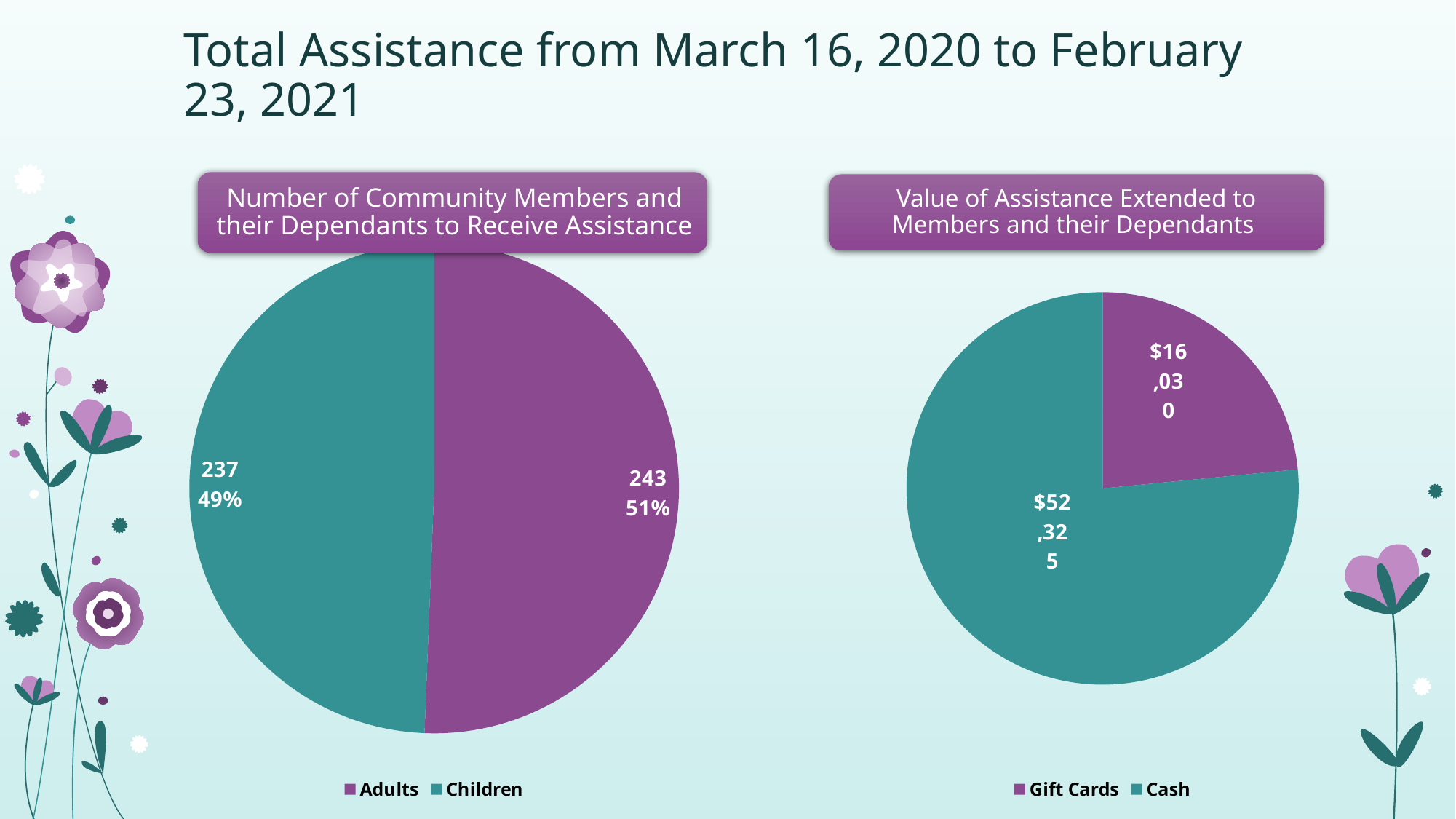
In the 'Value of Assistance Extended to Members and their Dependants' chart, what is the total value of Gift Cards and Cash combined? $68,355 In the 'Number of Community Members and their Dependants to Receive Assistance' chart, what is the total number of adults and children combined? 480 What type of chart is used for 'Value of Assistance Extended to Members and their Dependants'? Pie chart In the 'Value of Assistance Extended to Members and their Dependants' chart, what is the value of Gift Cards? $16,030 In the 'Value of Assistance Extended to Members and their Dependants' chart, which category has the larger value, Gift Cards or Cash? Cash In the 'Number of Community Members and their Dependants to Receive Assistance' chart, what percentage share do Adults have? 51% In the 'Number of Community Members and their Dependants to Receive Assistance' chart, what is the difference between the number of adults and the number of children? 6 How many categories does the legend of the 'Number of Community Members and their Dependants to Receive Assistance' chart list? 2 In the 'Value of Assistance Extended to Members and their Dependants' chart, what is the value of Cash? $52,325 In the 'Number of Community Members and their Dependants to Receive Assistance' chart, how many adults received assistance? 243 In the 'Number of Community Members and their Dependants to Receive Assistance' chart, what percentage share do Children have? 49% In the 'Number of Community Members and their Dependants to Receive Assistance' chart, how many children received assistance? 237